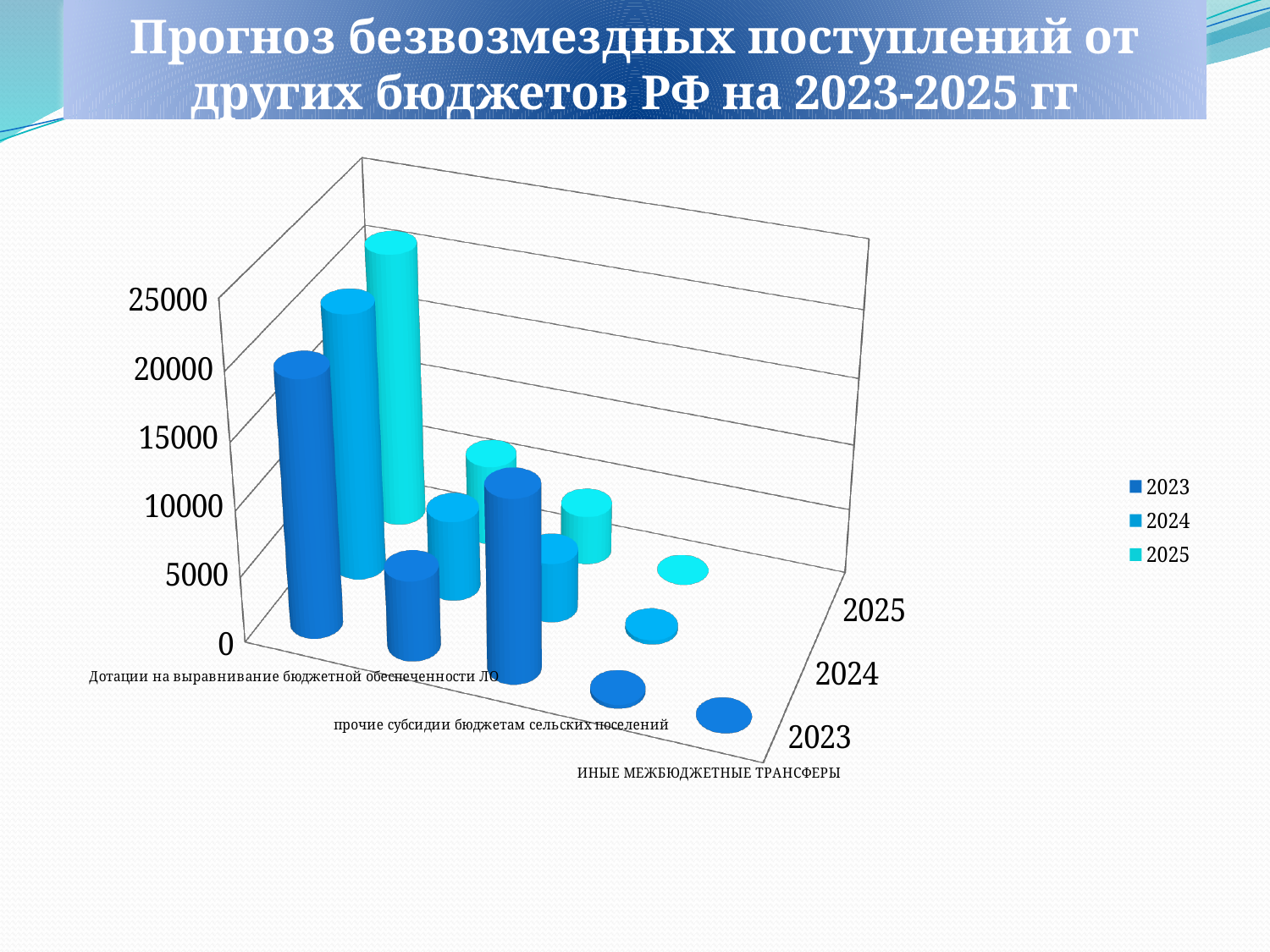
Do the values for Дотации на выравнивание бюджетной обеспеченности ЛО rise or fall from 2023 to 2025? rise Which category has the lowest values across all years? ИНЫЕ МЕЖБЮДЖЕТНЫЕ ТРАНСФЕРЫ Is the 2023 value for ИНЫЕ МЕЖБЮДЖЕТНЫЕ ТРАНСФЕРЫ greater or less than 5000? less What kind of chart is shown on the slide? bar chart What is the title of the chart? Прогноз безвозмездных поступлений от других бюджетов РФ на 2023-2025 гг Which category has the highest values across all years? Дотации на выравнивание бюджетной обеспеченности ЛО In 2025, which is larger: Дотации на выравнивание бюджетной обеспеченности ЛО or прочие субсидии бюджетам сельских поселений? Дотации на выравнивание бюджетной обеспеченности ЛО How many categories are plotted along the category axis? 5 Which years are listed in the legend? 2023, 2024, 2025 Is the 2023 value for Дотации на выравнивание бюджетной обеспеченности ЛО greater or less than 15000? greater How many series does the legend list? 3